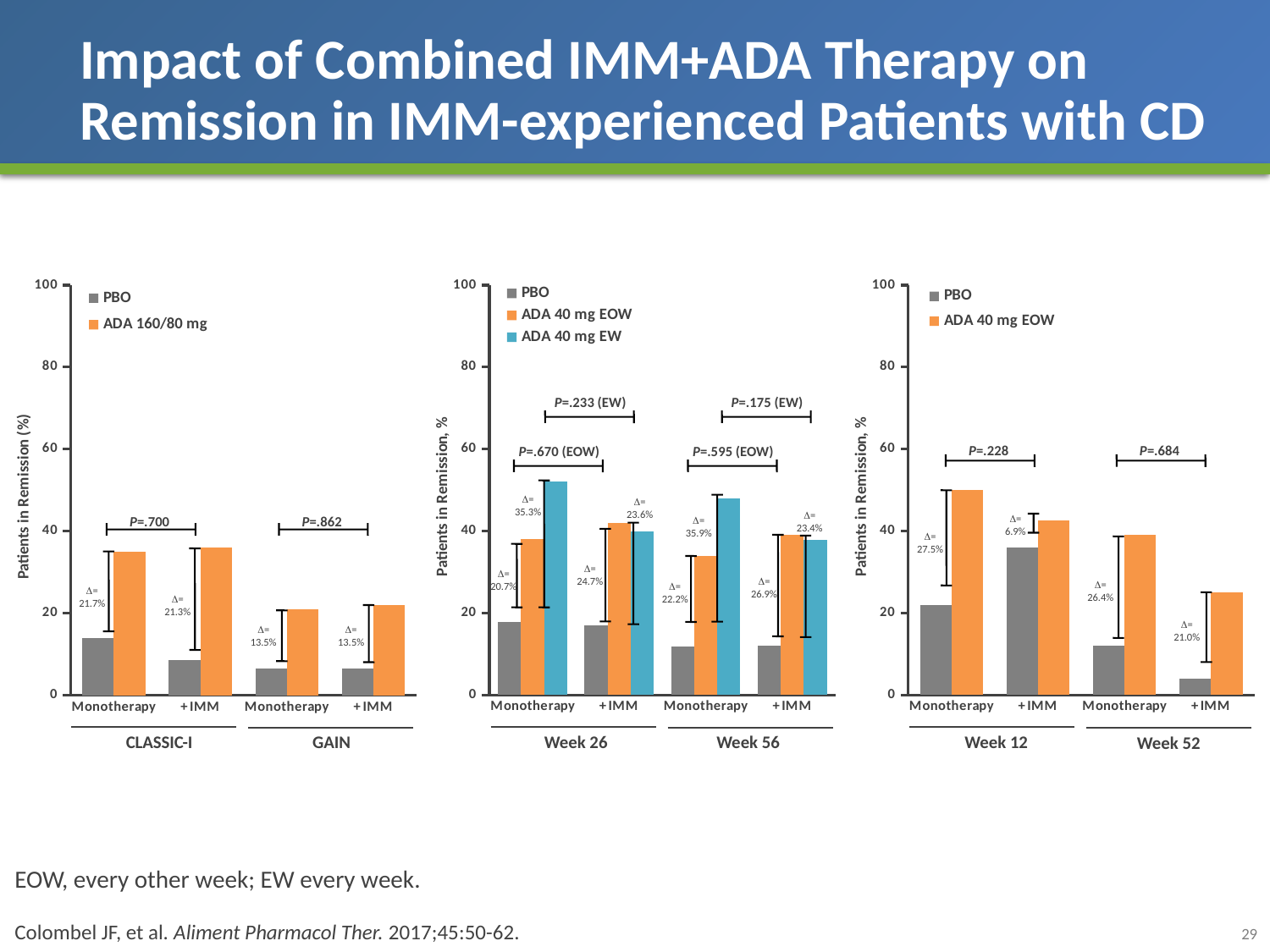
In the right chart, is the value for PBO in Week 52 +IMM greater or less than 20? less How many series does the legend of the middle chart (Week 26 / Week 56) list? 3 In the left chart, is the value for ADA 160/80 mg in CLASSIC-I Monotherapy greater or less than 20? greater In the right chart, which is larger for PBO at Week 12: Monotherapy or +IMM? +IMM In the right chart, what Δ value is printed for Week 12 Monotherapy? 27.5% What kind of chart is the left chart (CLASSIC-I / GAIN)? Bar chart What are the two legend entries on the right chart (Week 12 / Week 52)? PBO and ADA 40 mg EOW In the middle chart, which series has the highest value in Week 26 Monotherapy? ADA 40 mg EW In the left chart, what P-value is shown for the CLASSIC-I comparison? P=.700 In the left chart, is the value for PBO in GAIN Monotherapy greater or less than 20? less In the middle chart, what Δ value is printed for ADA 40 mg EW in Week 26 Monotherapy? 35.3%